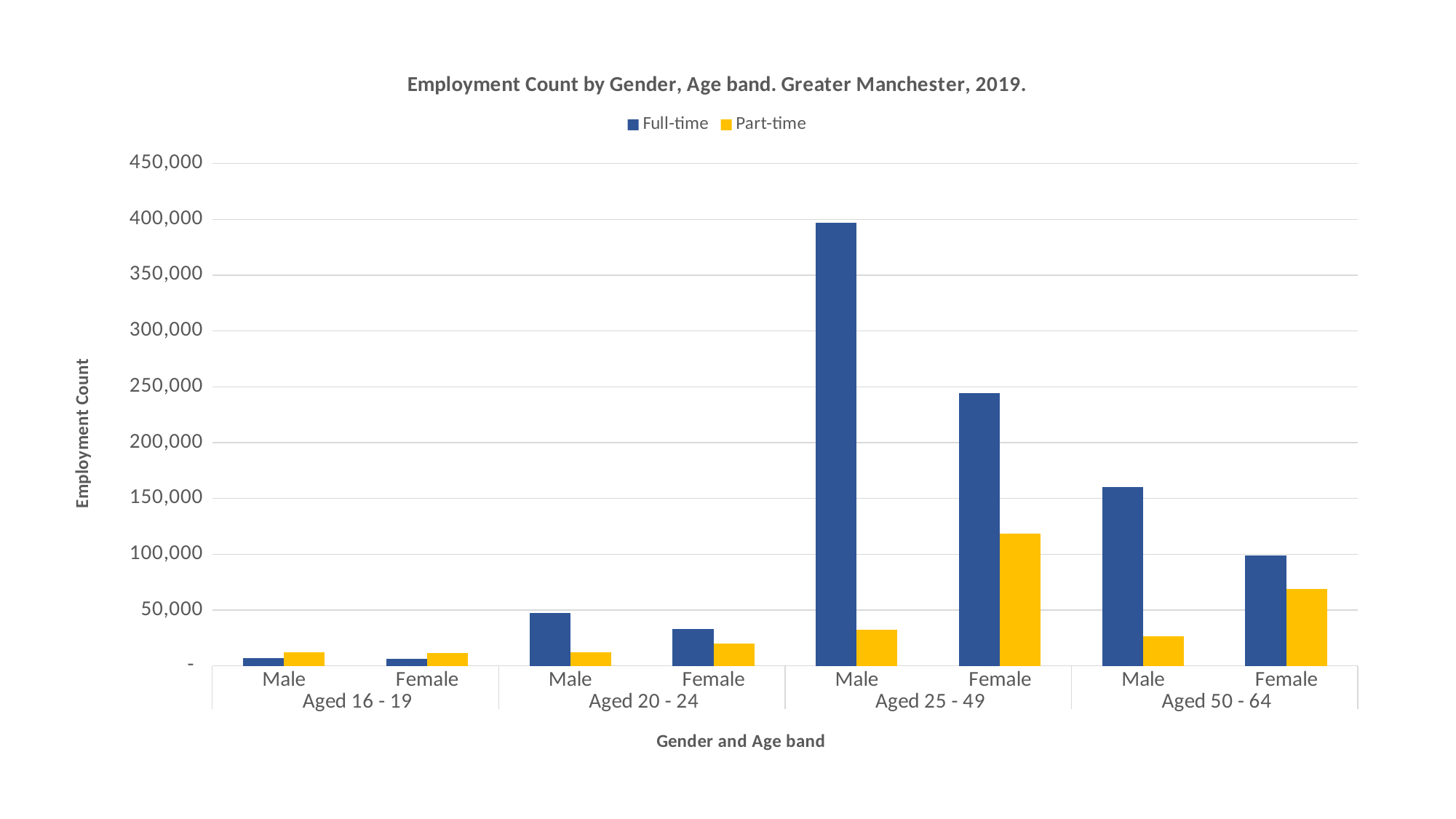
Is the Full-time value for Female, Aged 20 - 24 greater or less than 50,000? less Which category has the highest Full-time employment count? Male, Aged 25 - 49 How many gender-and-age-band categories are plotted along the x axis? 8 Which is larger: the Part-time value for Female, Aged 25 - 49 or the Full-time value for Male, Aged 50 - 64? Full-time value for Male, Aged 50 - 64 For Male, Aged 25 - 49, which is larger: the Full-time or the Part-time employment count? Full-time Which category has the highest Part-time employment count? Female, Aged 25 - 49 How many series does the legend list? 2 Is the Full-time value for Male, Aged 25 - 49 greater or less than 350,000? greater Is the Full-time value for Female, Aged 25 - 49 greater or less than 200,000? greater What are the two series named in the legend? Full-time and Part-time What kind of chart is shown on the slide? Bar chart